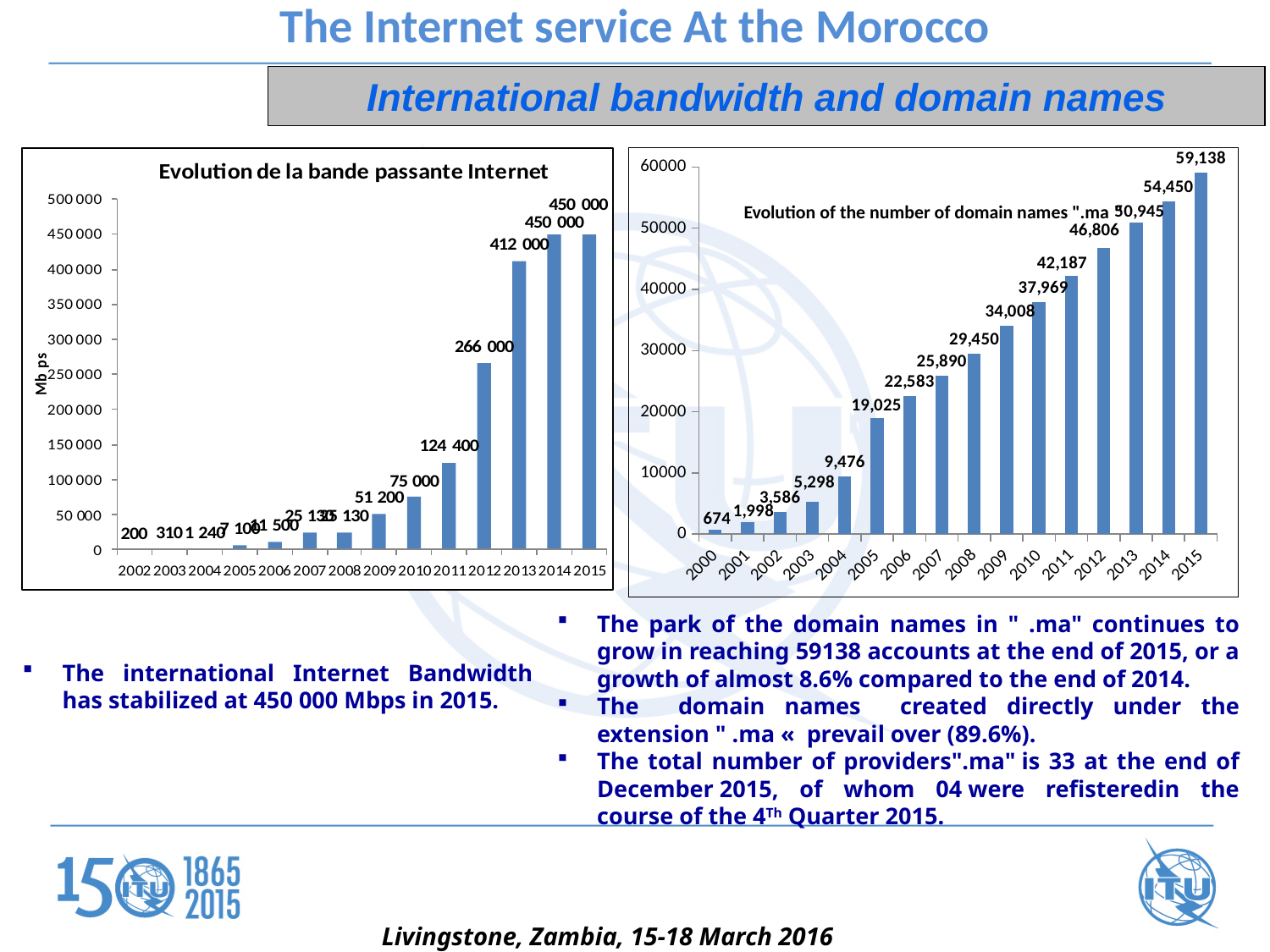
In the chart on the left (Evolution de la bande passante Internet), what is the value for 2011? 124 400 How many years are shown on the x axis of the chart on the right? 16 In the chart on the right, what is the difference between the 2015 and 2014 values? 4,688 In the chart on the right, what is the value shown for 2000? 674 What type of chart is the chart on the right (Evolution of the number of domain names ".ma")? Bar chart In the chart on the left (Evolution de la bande passante Internet), what is the difference between the 2013 and 2012 values? 146 000 In the chart on the right, how many domain names ".ma" were there in 2015? 59,138 In the chart on the right, do the values rise or fall from 2000 to 2015? Rise In the chart on the right, which year has the highest number of domain names? 2015 In the chart on the left (Evolution de la bande passante Internet), what is the value for 2013? 412 000 In the chart on the right, what is the number of domain names ".ma" for 2005? 19,025 In the chart on the left (Evolution de la bande passante Internet), which year has the lowest value? 2002